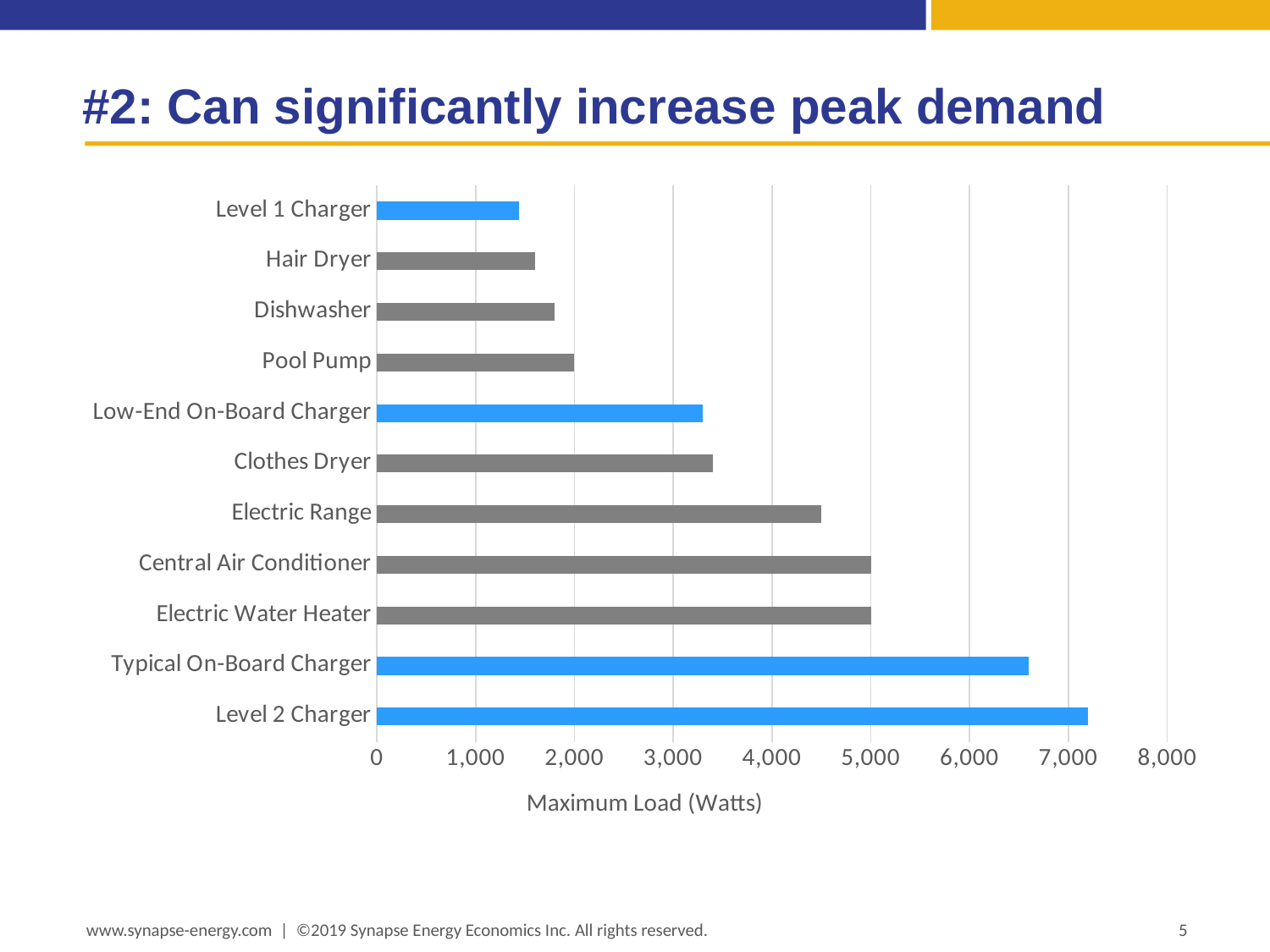
Which has a larger maximum load, Clothes Dryer or Dishwasher? Clothes Dryer How many categories are plotted on the chart? 11 Which category has the highest maximum load? Level 2 Charger Is the value for Low-End On-Board Charger greater or less than 4,000? less Which categories are shown with blue bars rather than grey bars? Level 1 Charger, Low-End On-Board Charger, Typical On-Board Charger, Level 2 Charger What is the title of the horizontal axis? Maximum Load (Watts) What kind of chart is shown on the slide? bar chart Is the value for Hair Dryer greater or less than 2,000? less Is the value for Level 2 Charger greater or less than 7,000? greater Which has a larger maximum load, Typical On-Board Charger or Electric Water Heater? Typical On-Board Charger